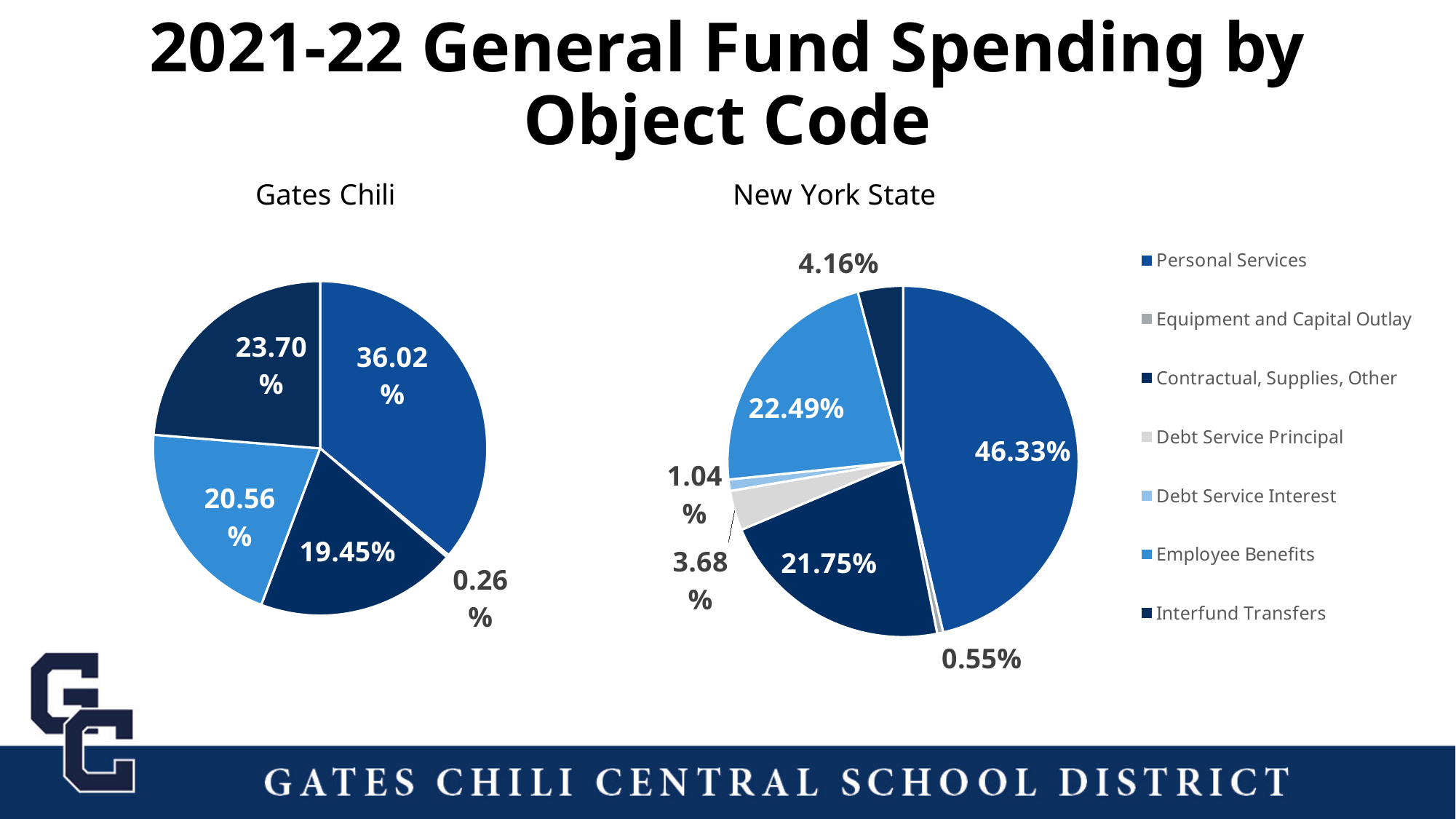
How many slices does the New York State pie chart have? 7 In the New York State pie chart, what share of spending is Interfund Transfers? 4.16% In the New York State pie chart, which category has the smallest slice? Equipment and Capital Outlay Which chart shows a larger share for Personal Services, Gates Chili or New York State? New York State What type of chart is used for Gates Chili and New York State? Pie chart In the New York State pie chart, what share of spending is Personal Services? 46.33% How many categories does the legend list? 7 In the Gates Chili pie chart, what share of spending is Personal Services? 36.02% In the Gates Chili pie chart, which category has the largest slice? Personal Services In the New York State pie chart, what share of spending is Employee Benefits? 22.49% What is the difference between the Personal Services share in the New York State chart and in the Gates Chili chart? 10.31% In the New York State pie chart, what share of spending is Contractual, Supplies, Other? 21.75%